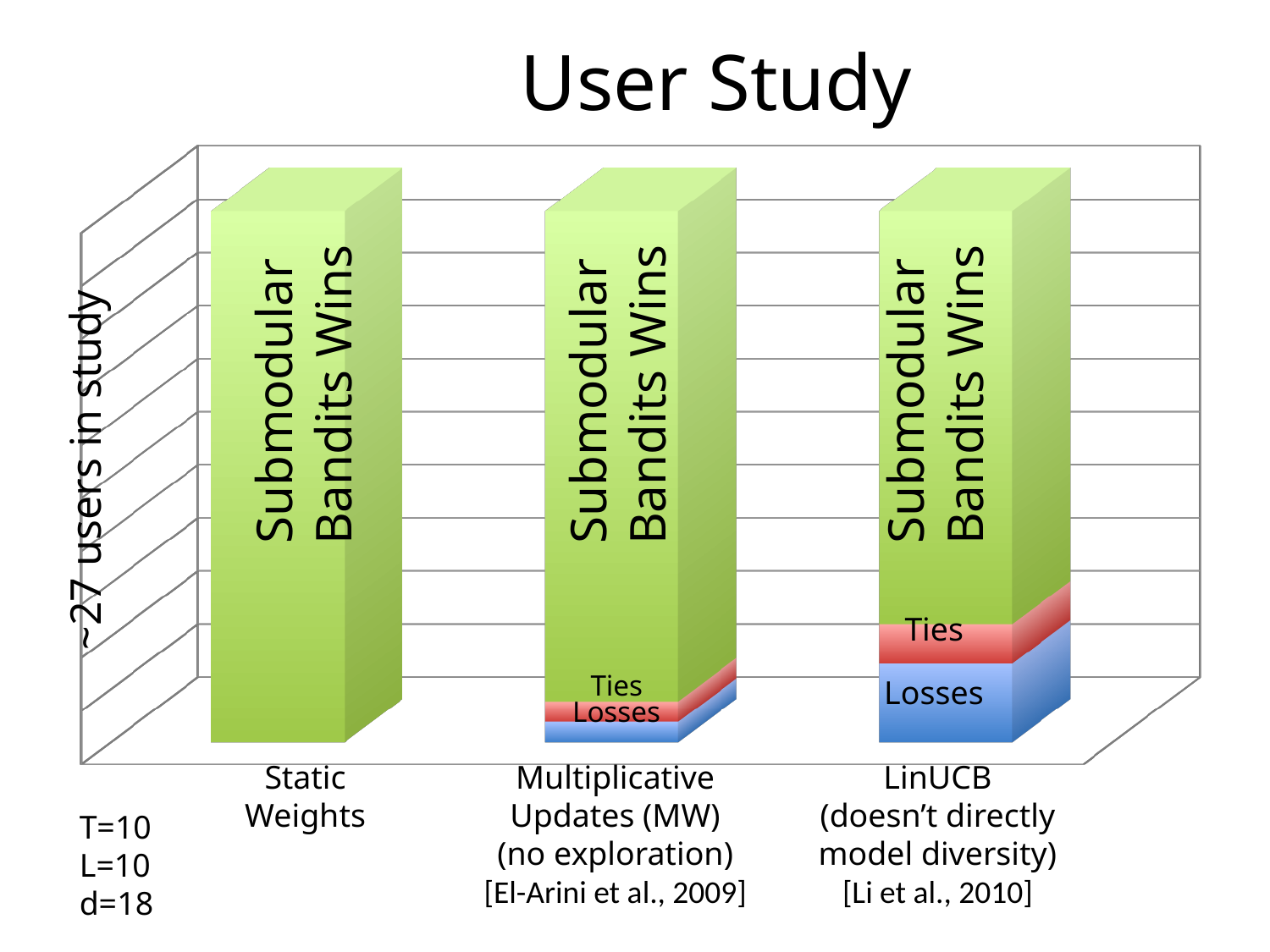
Which category shows no 'Ties' or 'Losses' segments at all? Static Weights What kind of chart is shown on the slide? Stacked bar chart Which category has the smallest 'Submodular Bandits Wins' segment? LinUCB Is the 'Ties' segment larger for LinUCB or for Multiplicative Updates (MW)? LinUCB What is the title of the chart? User Study Which category has the largest 'Losses' segment? LinUCB Which category has the largest 'Submodular Bandits Wins' segment? Static Weights How many categories (bars) are shown on the x axis? 3 Does the 'Submodular Bandits Wins' segment rise or fall moving from Static Weights to LinUCB along the x axis? Fall How many distinct segment types (Wins, Ties, Losses) are stacked in the LinUCB bar? 3 Is the 'Losses' segment larger for LinUCB or for Multiplicative Updates (MW)? LinUCB What is the label on the vertical axis? ~27 users in study